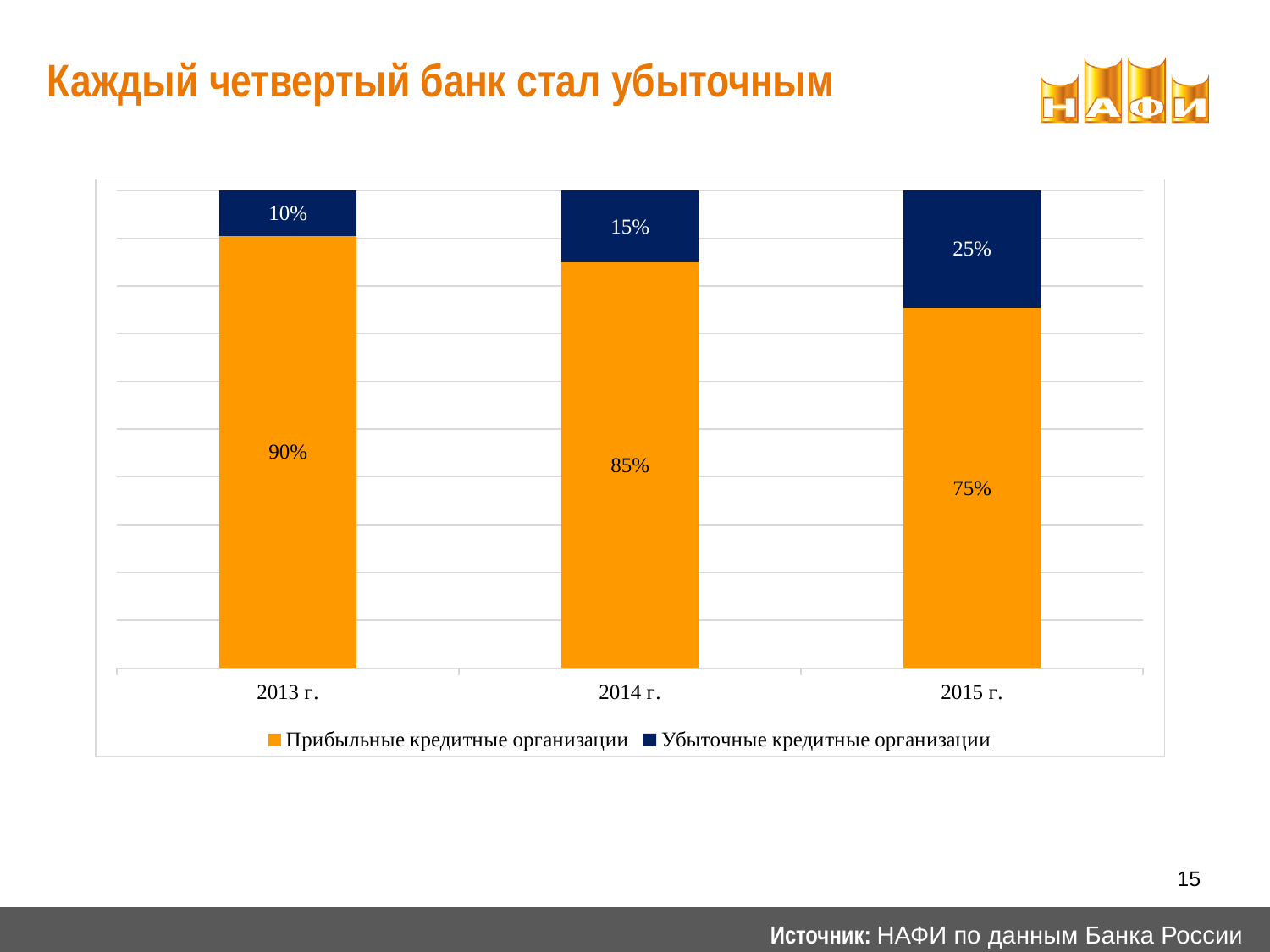
What is the value for Убыточные кредитные организации in 2014 г.? 15% What is the total of the stacked bar for 2014 г.? 100% In which year is the share of Прибыльные кредитные организации lowest? 2015 г. What is the value for Убыточные кредитные организации in 2015 г.? 25% How many years are shown on the x axis? 3 Does the share of Убыточные кредитные организации rise or fall from 2013 г. to 2015 г.? Rise In which year is the share of Убыточные кредитные организации highest? 2015 г. What kind of chart is shown on the slide? Stacked bar chart What is the difference between the Прибыльные кредитные организации values for 2013 г. and 2015 г.? 15% Which is larger: Убыточные кредитные организации in 2014 г. or in 2013 г.? 2014 г. What is the value for Прибыльные кредитные организации in 2013 г.? 90% How many series does the legend list? 2